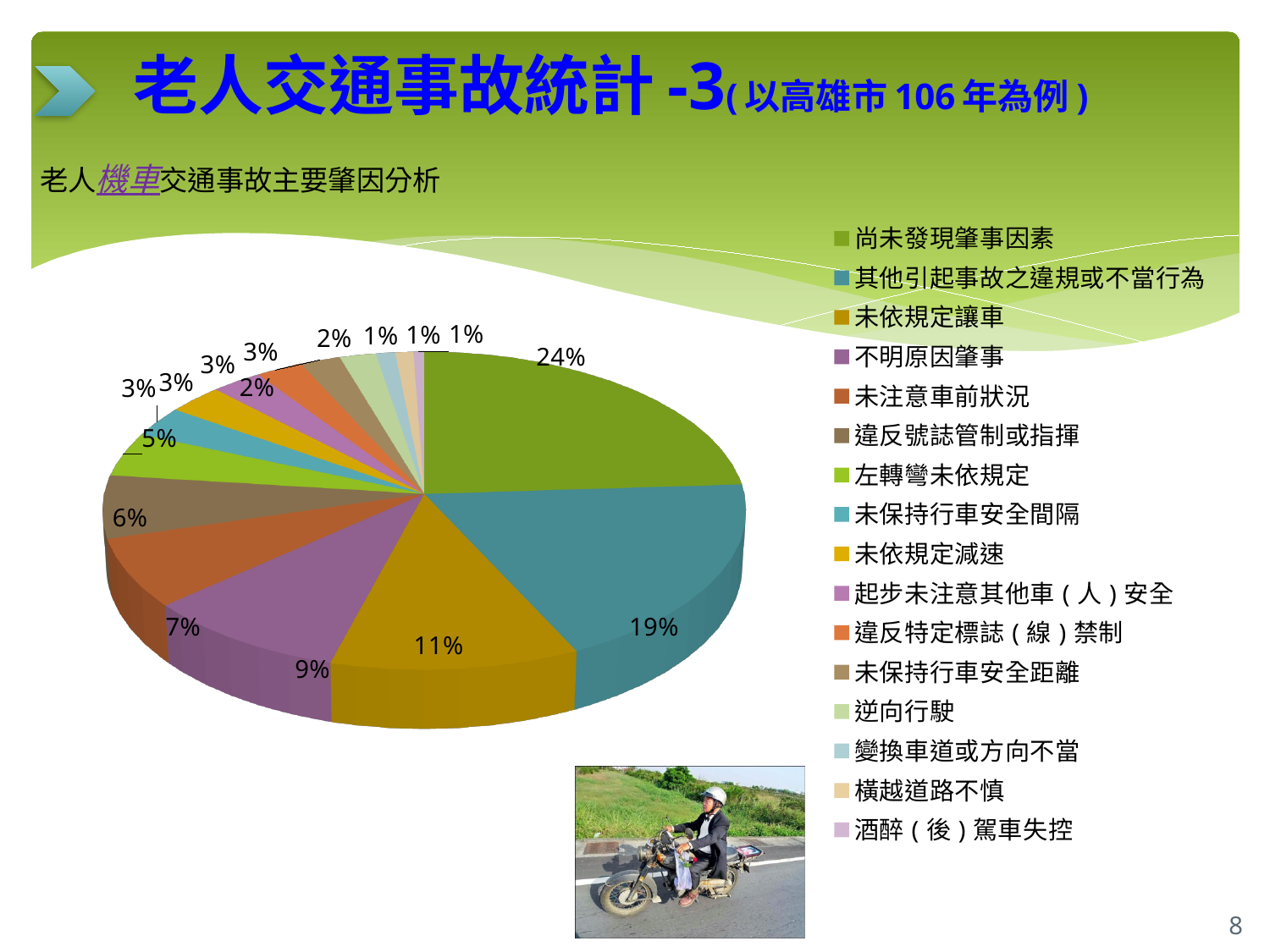
What share of the pie does 尚未發現肇事因素 account for? 24% What is the difference in percentage points between 尚未發現肇事因素 and 其他引起事故之違規或不當行為? 5 What percentage is shown for 未注意車前狀況? 7% Which category has the largest slice of the pie? 尚未發現肇事因素 What percentage is shown for 不明原因肇事? 9% How many categories does the legend list? 16 What type of chart is shown on the slide? pie chart What percentage is shown for 未依規定讓車? 11% What is the subtitle text above the chart? 老人機車交通事故主要肇因分析 Which is larger, the slice for 未依規定讓車 or the slice for 不明原因肇事? 未依規定讓車 What percentage is shown for 違反號誌管制或指揮? 6% What percentage is shown for 其他引起事故之違規或不當行為? 19%